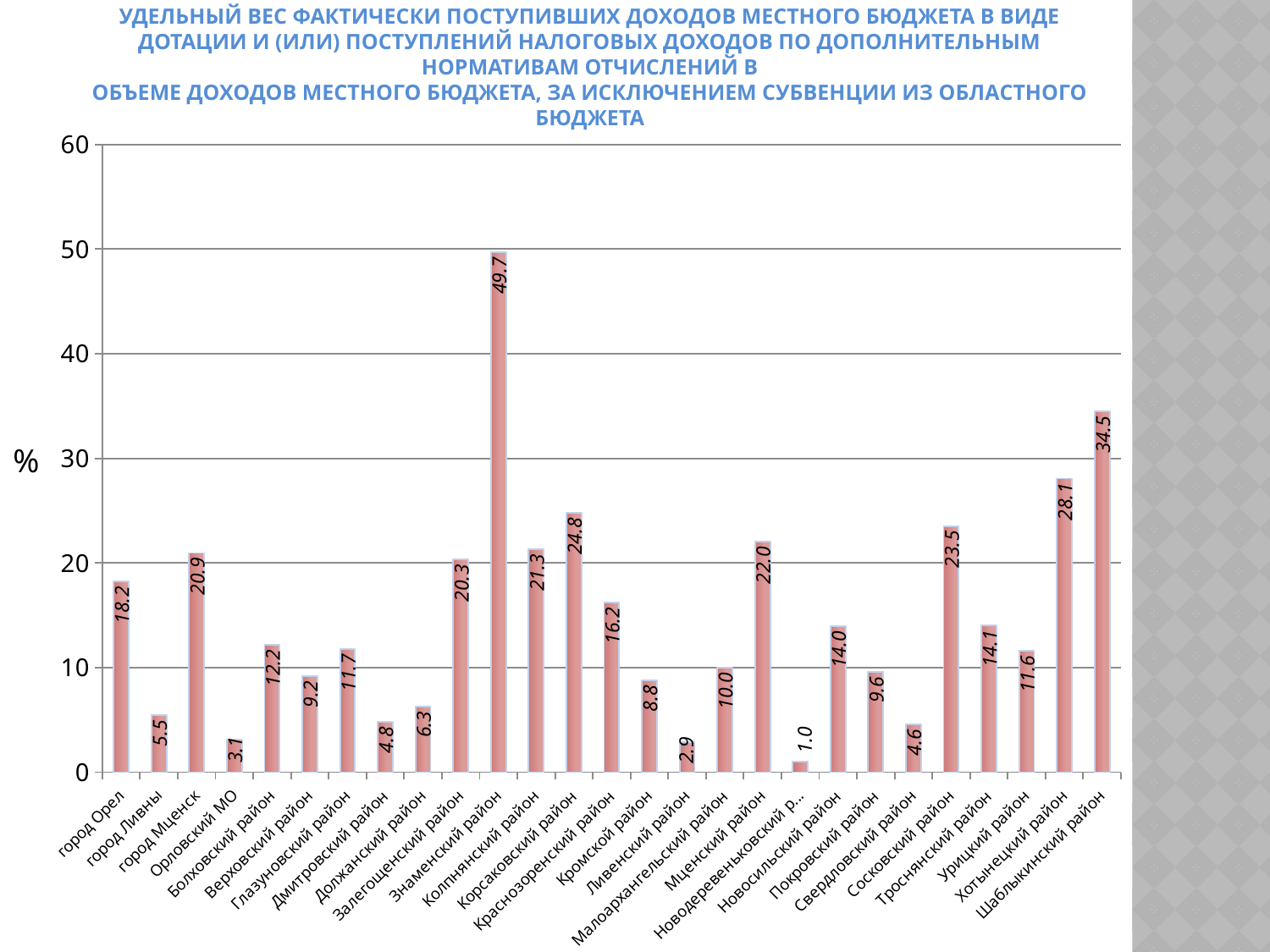
How many categories are shown on the x axis? 27 What label is shown on the vertical axis? % What kind of chart is shown on the slide? bar chart Which category has the highest value? Знаменский район Is the value for Сосковский район greater or less than 20? greater What is the value for город Орел? 18.2 What is the difference between the values for Шаблыкинский район and Хотынецкий район? 6.4 What is the lowest value shown on the chart? 1.0 What is the value for Малоархангельский район? 10.0 Which is larger, the value for город Орел or the value for город Мценск? город Мценск What is the value for Знаменский район? 49.7 What is the value for Хотынецкий район? 28.1